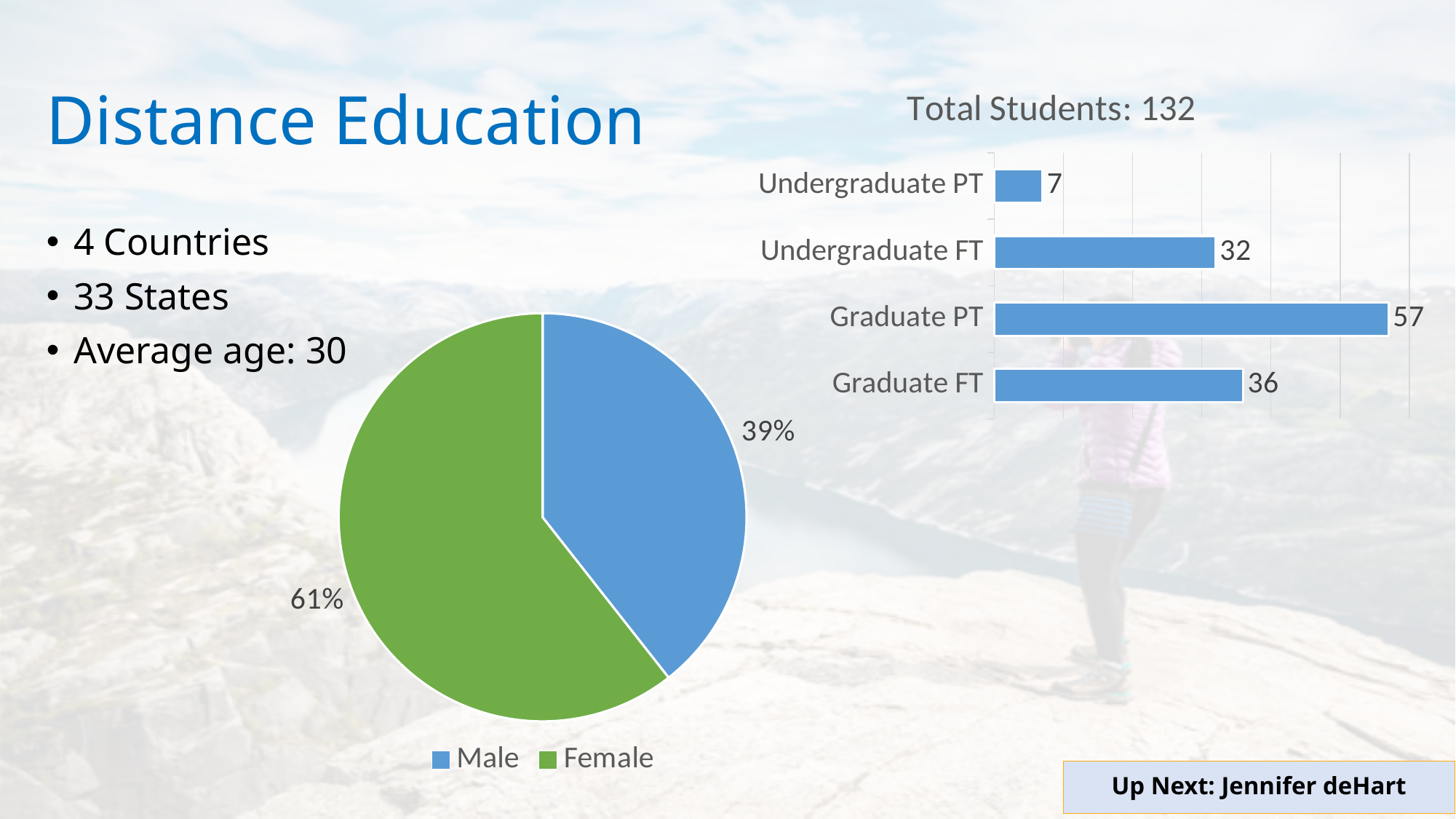
In the bar chart on the right, what is the value for Undergraduate FT? 32 In the pie chart, what share is Female? 61% In the bar chart on the right, what is the difference between Graduate PT and Graduate FT? 21 In the pie chart, what share is Male? 39% In the bar chart on the right, what is the value for Graduate PT? 57 In the bar chart on the right, which category has the highest value? Graduate PT What is the title shown above the bar chart on the right? Total Students: 132 In the bar chart on the right, which is larger, Undergraduate FT or Graduate FT? Graduate FT How many categories does the bar chart on the right show? 4 What kind of chart is the chart on the right of the slide? Bar chart In the bar chart on the right, which category has the lowest value? Undergraduate PT In the pie chart, which slice is larger, Male or Female? Female